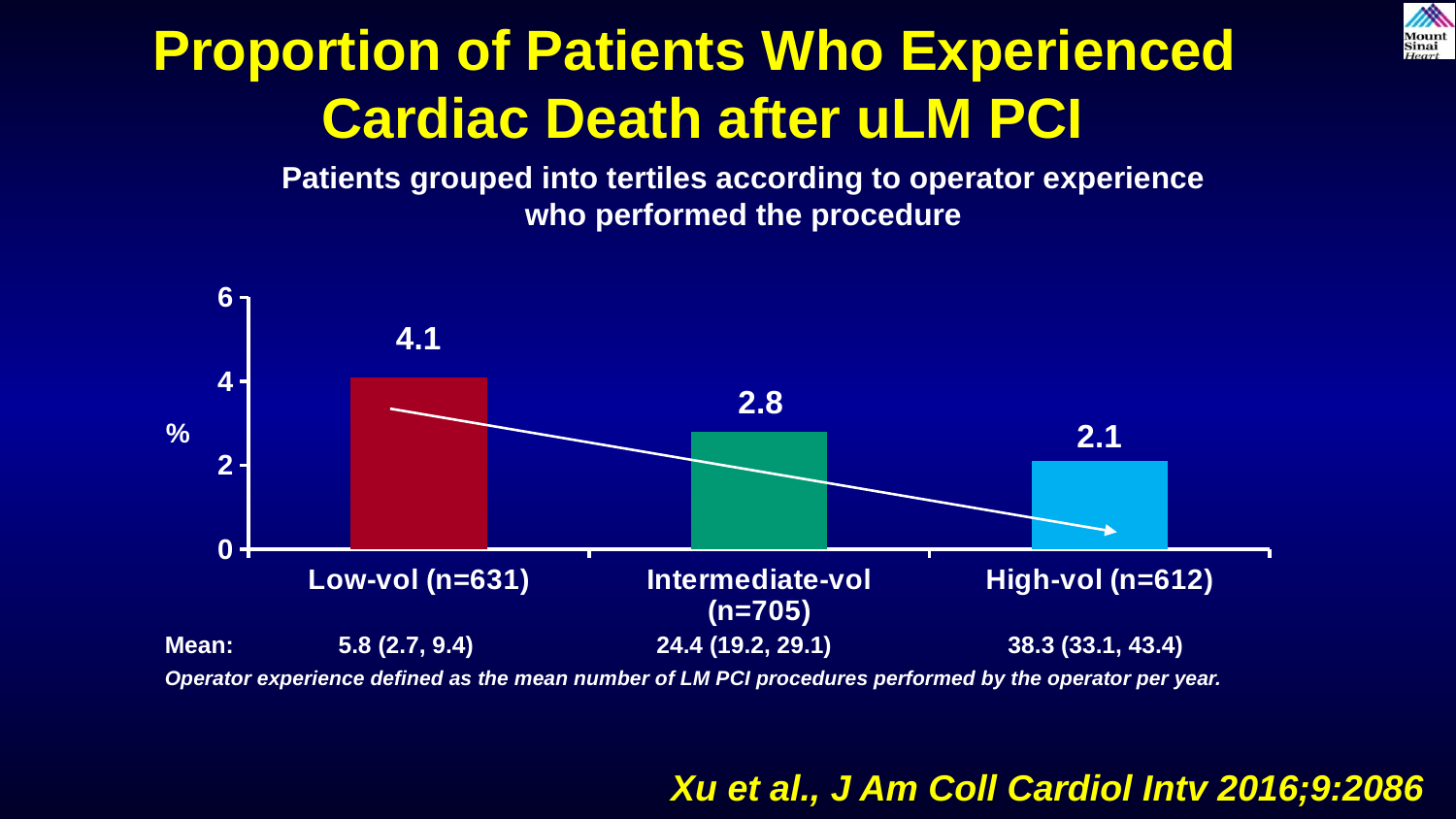
What is the value for Low-vol (n=631)? 4.1 Which category has the highest value? Low-vol (n=631) What is the value for Intermediate-vol (n=705)? 2.8 What is the value for High-vol (n=612)? 2.1 What kind of chart is shown on the slide? bar chart Which category has the lowest value? High-vol (n=612) What is the difference between the values for Low-vol (n=631) and Intermediate-vol (n=705)? 1.3 Is the value for Low-vol (n=631) greater or less than 4? greater Which is larger, the value for Intermediate-vol (n=705) or High-vol (n=612)? Intermediate-vol (n=705) What is the difference between the values for Low-vol (n=631) and High-vol (n=612)? 2.0 How many categories are shown on the x axis? 3 Do the values rise or fall from Low-vol to High-vol along the x axis? fall